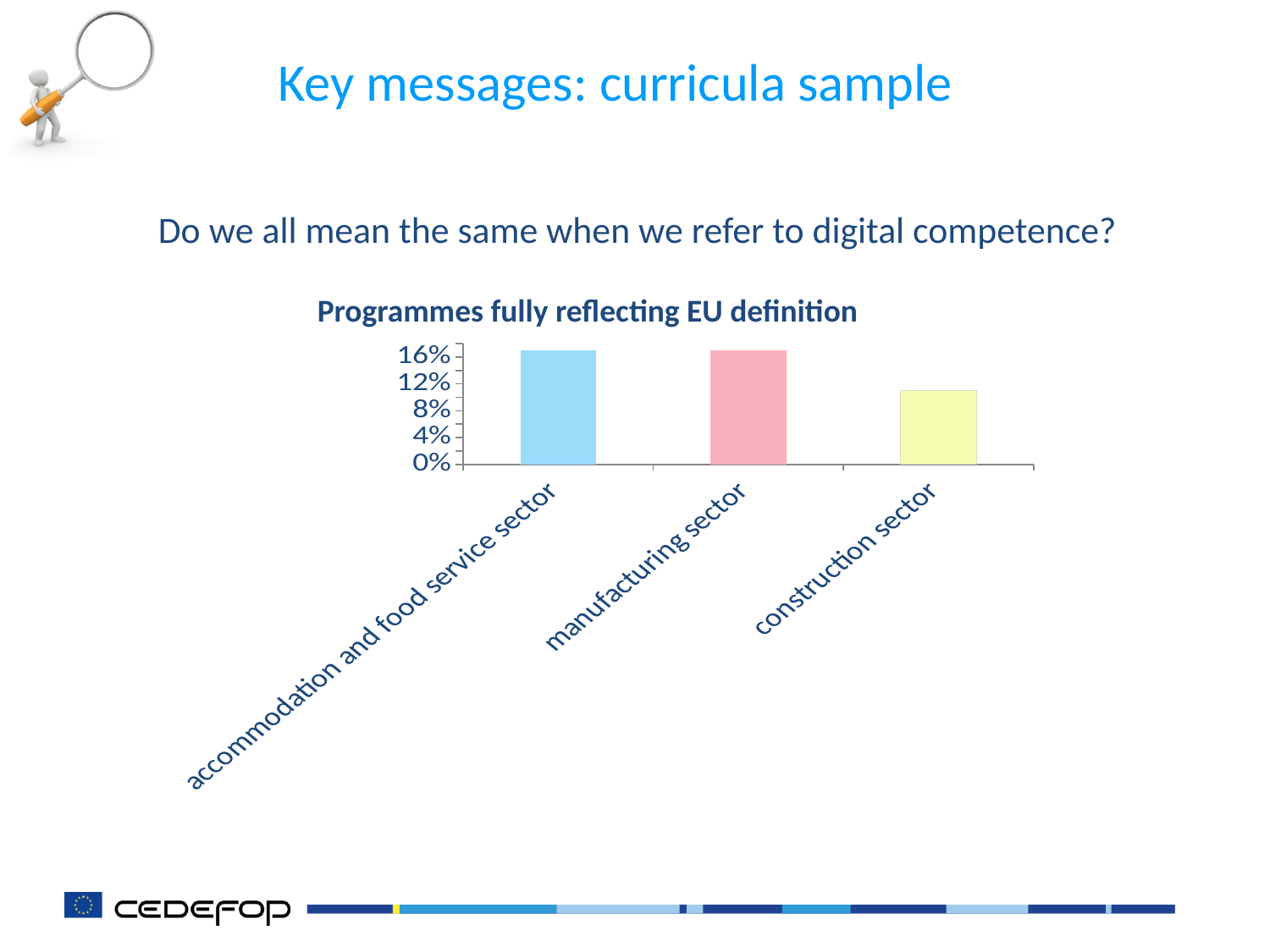
Is the value for the accommodation and food service sector greater or less than 12%? greater Which sector has the lowest share of programmes fully reflecting the EU definition? construction sector Which is larger, the value for the manufacturing sector or the construction sector? manufacturing sector What kind of chart is shown on the slide? bar chart How many sectors are shown in the chart? 3 Is the value for the construction sector greater or less than 8%? greater Which is larger, the value for the accommodation and food service sector or the construction sector? accommodation and food service sector What is the title of the chart? Programmes fully reflecting EU definition What colour is the bar for the manufacturing sector? pink Is the value for the manufacturing sector greater or less than 12%? greater